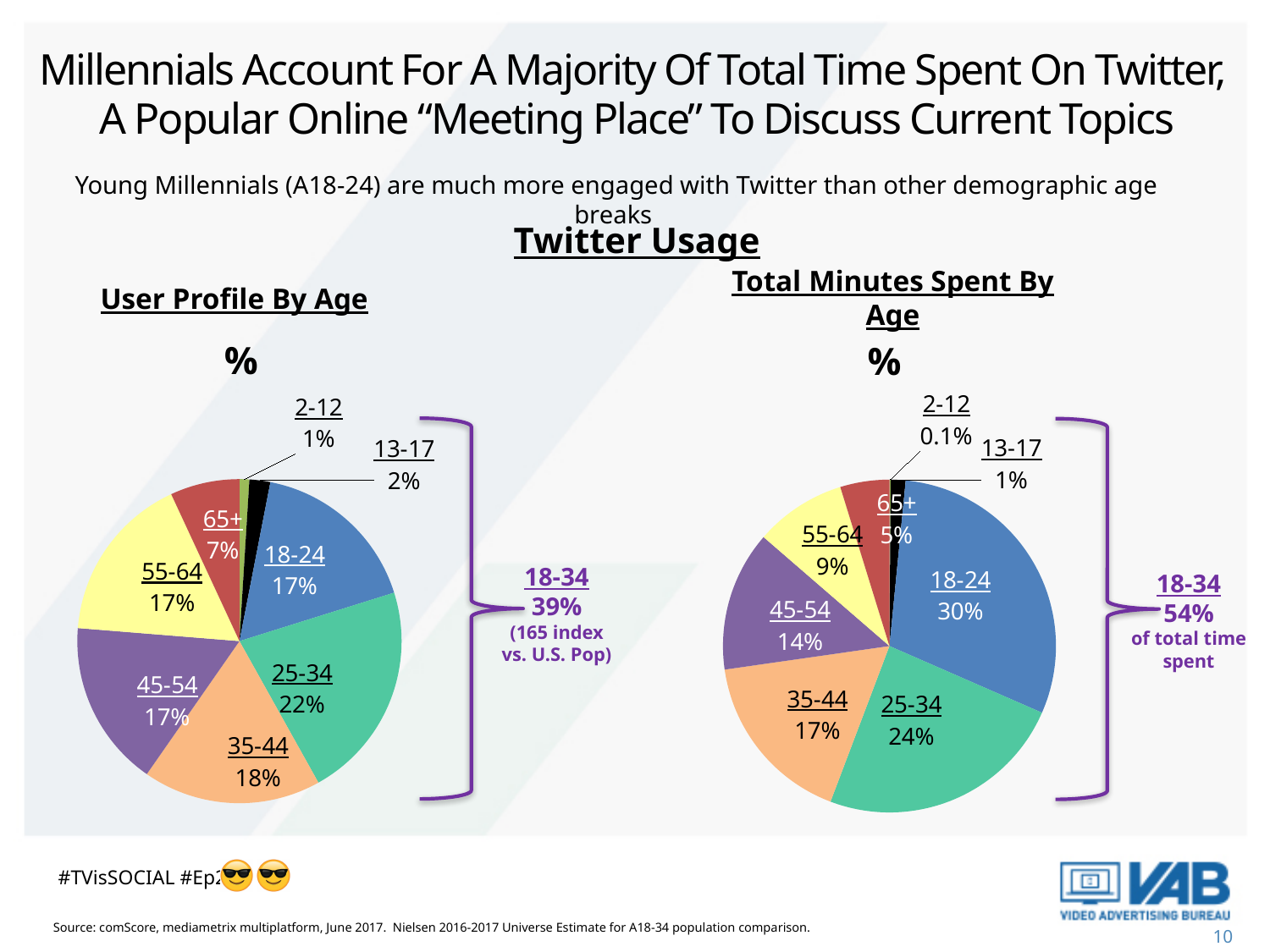
What type of chart is used for Total Minutes Spent By Age? Pie chart In the Total Minutes Spent By Age pie chart, what is the difference between the 18-24 share and the 25-34 share? 6% How many age groups are shown in the User Profile By Age pie chart? 8 In the User Profile By Age pie chart, what percentage is shown for the 25-34 age group? 22% In the Total Minutes Spent By Age pie chart, which age group has the smallest share? 2-12 In the Total Minutes Spent By Age pie chart, what percentage is shown for the 18-24 age group? 30% In the User Profile By Age pie chart, which is larger: the share for 35-44 or the share for 65+? 35-44 In the User Profile By Age pie chart, which age group has the largest share? 25-34 In the User Profile By Age pie chart, what share of the pie does the 55-64 age group represent? 17% What is the title of the pie chart on the left side of the slide? User Profile By Age In the Total Minutes Spent By Age pie chart, what percentage is shown for the 2-12 age group? 0.1% According to the annotation next to the Total Minutes Spent By Age pie chart, what percentage of total time spent is accounted for by the 18-34 group? 54%